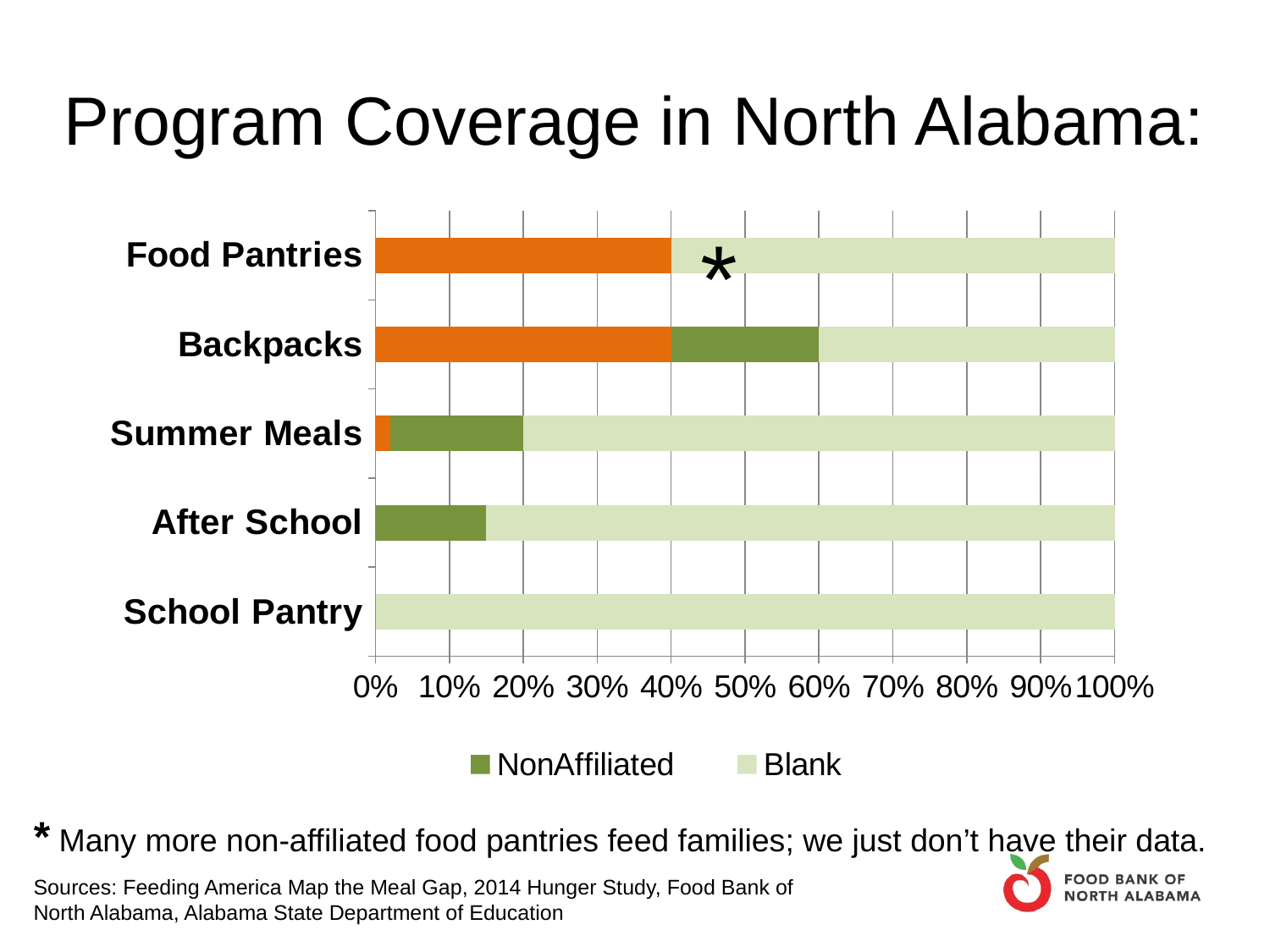
At what percentage does the orange segment for Backpacks end? 40% At what percentage does the orange segment for Food Pantries end? 40% Which has the larger orange segment, Backpacks or Summer Meals? Backpacks Is the orange segment for Summer Meals greater or less than 10%? less Which category's bar is marked with an asterisk? Food Pantries Is the NonAffiliated segment for After School greater or less than 20%? less Which category's bar is entirely Blank, with no orange or NonAffiliated segment? School Pantry Is the NonAffiliated segment for After School greater or less than 10%? greater How many series does the chart's legend list? 2 How many program categories are listed on the vertical axis of the chart? 5 What is the title of the chart? Program Coverage in North Alabama: What kind of chart is shown on the slide? bar chart